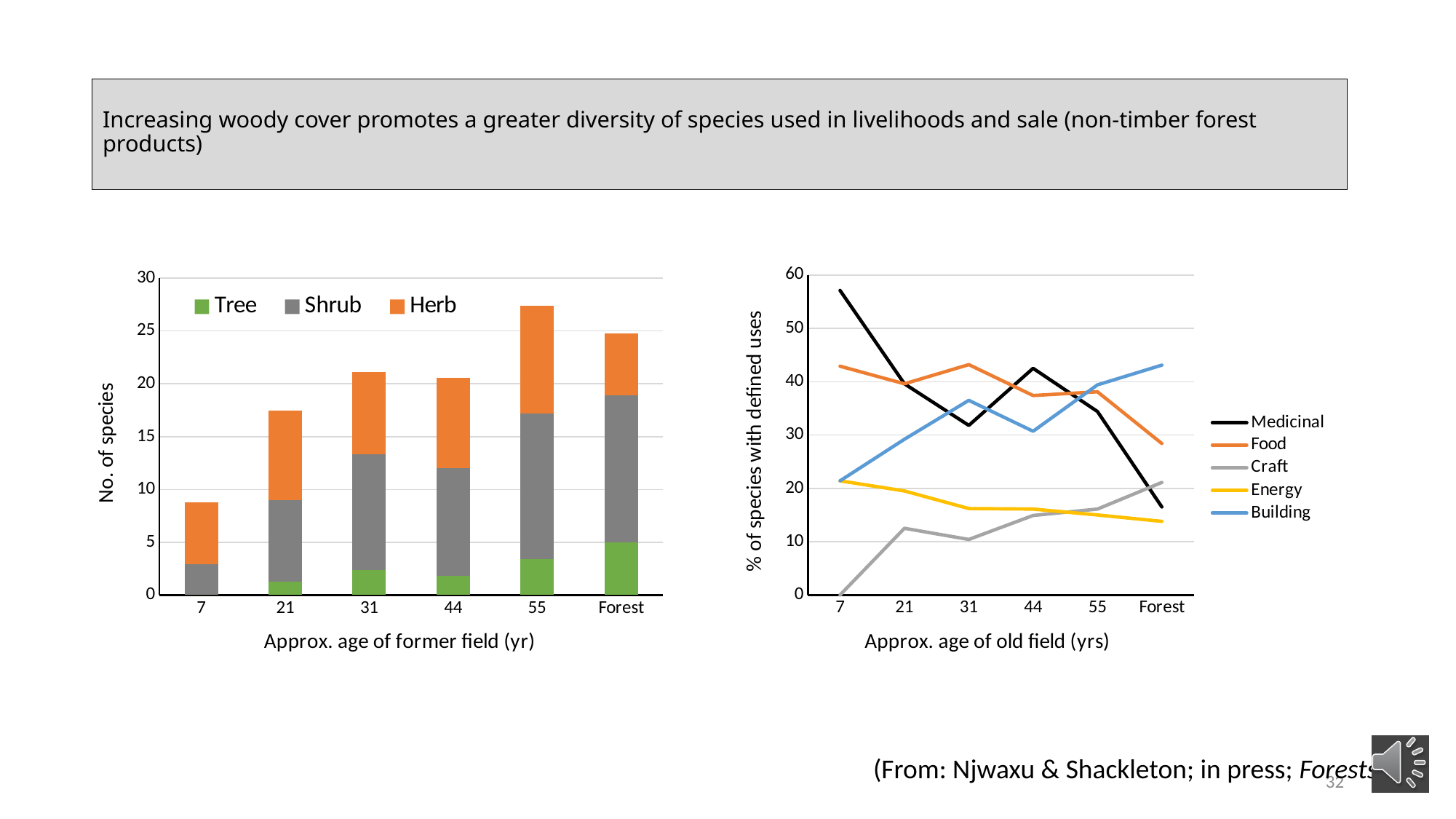
How many series does the legend of the right chart list? 5 In the right chart, is the Medicinal value at age 7 greater or less than 50? greater In the right chart, does the Medicinal line generally rise or fall from age 7 to Forest? fall In the left chart, is the total number of species for the 7-year field greater or less than 10? less How many series does the legend of the left chart list? 3 What kind of chart is the right chart showing % of species with defined uses? line chart What kind of chart is the left chart showing number of species? stacked bar chart In the right chart, which series has the highest value at age 7? Medicinal In the left chart, which field age has the shortest total bar? 7 How many categories are shown on the x axis of the left chart? 6 In the left chart, is the total number of species for the 55-year field greater or less than 25? greater In the left chart, which field age has the tallest total bar? 55